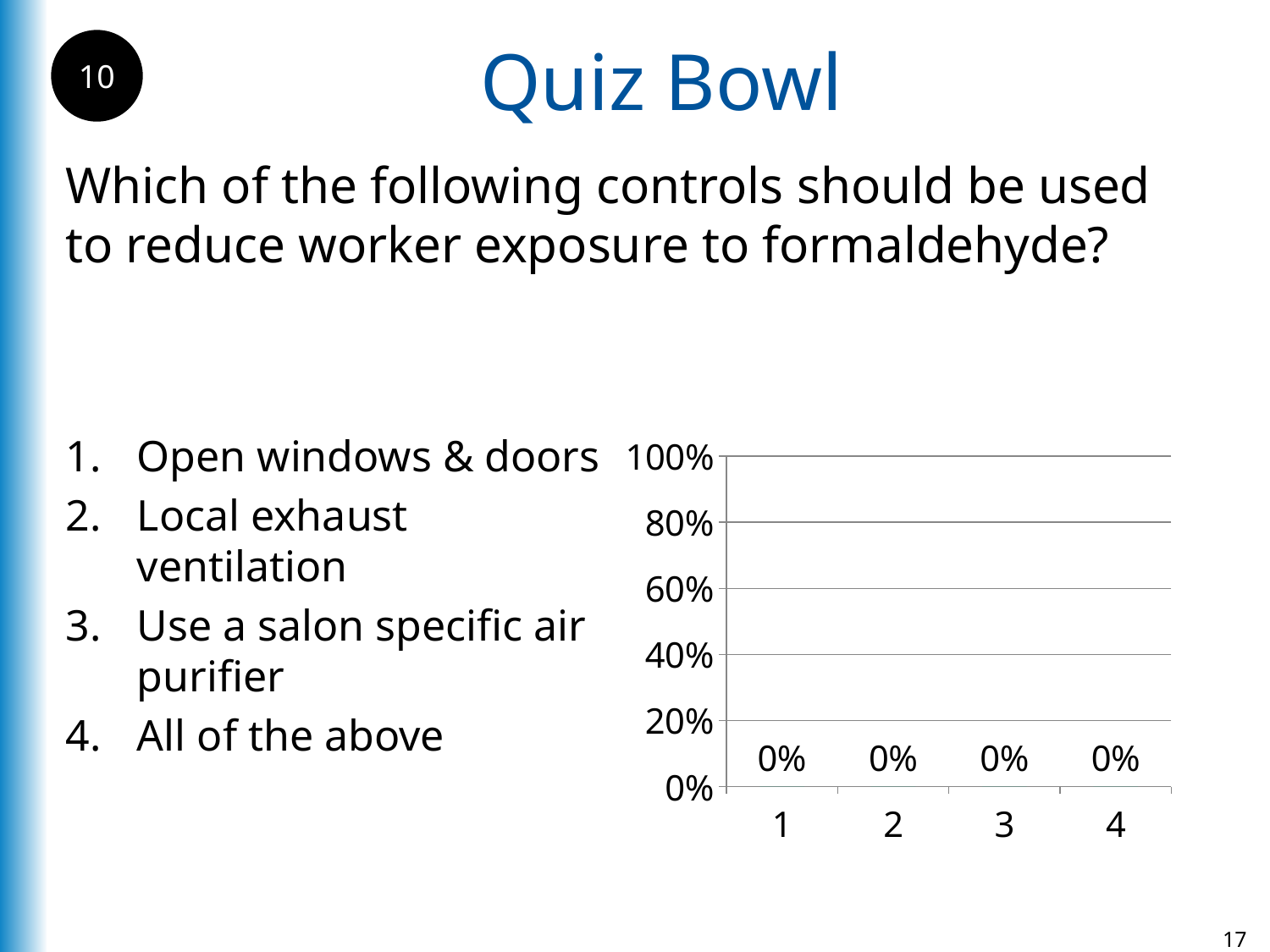
What is the value for category 4 in the chart? 0% Do the values rise, fall, or stay the same across categories 1 to 4? stay the same What is the value for category 3 in the chart? 0% How many categories are shown on the x axis of the chart? 4 What is the value for category 2 in the chart? 0% Is the value for category 2 greater or less than 20%? less What kind of chart is shown on the slide? bar chart What is the value for category 1 in the chart? 0% What is the difference between the values for category 1 and category 4? 0% What is the highest value shown on the y axis of the chart? 100% What is the interval between the tick marks on the y axis of the chart? 20%